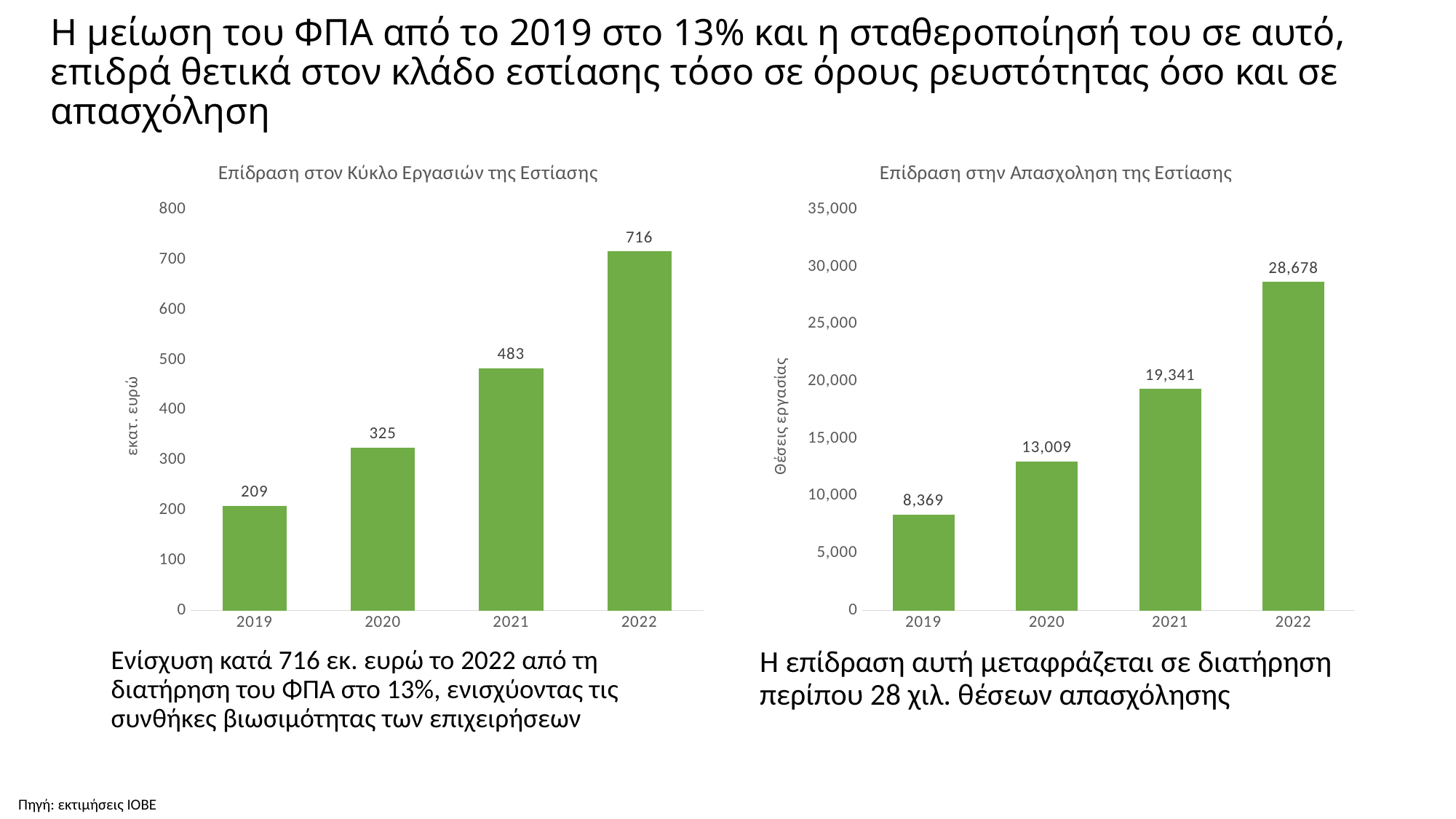
In the right chart (Επίδραση στην Απασχοληση της Εστίασης), what is the difference between the values for 2021 and 2020? 6,332 In the left chart (Επίδραση στον Κύκλο Εργασιών της Εστίασης), what is the difference between the values for 2022 and 2019? 507 What kind of chart is the right chart (Επίδραση στην Απασχοληση της Εστίασης)? Bar chart In the left chart (Επίδραση στον Κύκλο Εργασιών της Εστίασης), is the value for 2020 greater or less than 300? greater In the right chart (Επίδραση στην Απασχοληση της Εστίασης), which year has the lowest value? 2019 In the right chart (Επίδραση στην Απασχοληση της Εστίασης), which is larger, the value for 2021 or the value for 2022? 2022 How many years are shown on the x axis of the left chart (Επίδραση στον Κύκλο Εργασιών της Εστίασης)? 4 In the left chart (Επίδραση στον Κύκλο Εργασιών της Εστίασης), which year has the highest value? 2022 In the left chart (Επίδραση στον Κύκλο Εργασιών της Εστίασης), what is the value for 2021? 483 In the right chart (Επίδραση στην Απασχοληση της Εστίασης), what is the value for 2020? 13,009 In the left chart (Επίδραση στον Κύκλο Εργασιών της Εστίασης), do the values rise or fall from 2019 to 2022? Rise What is the y-axis label of the right chart (Επίδραση στην Απασχοληση της Εστίασης)? Θέσεις εργασίας